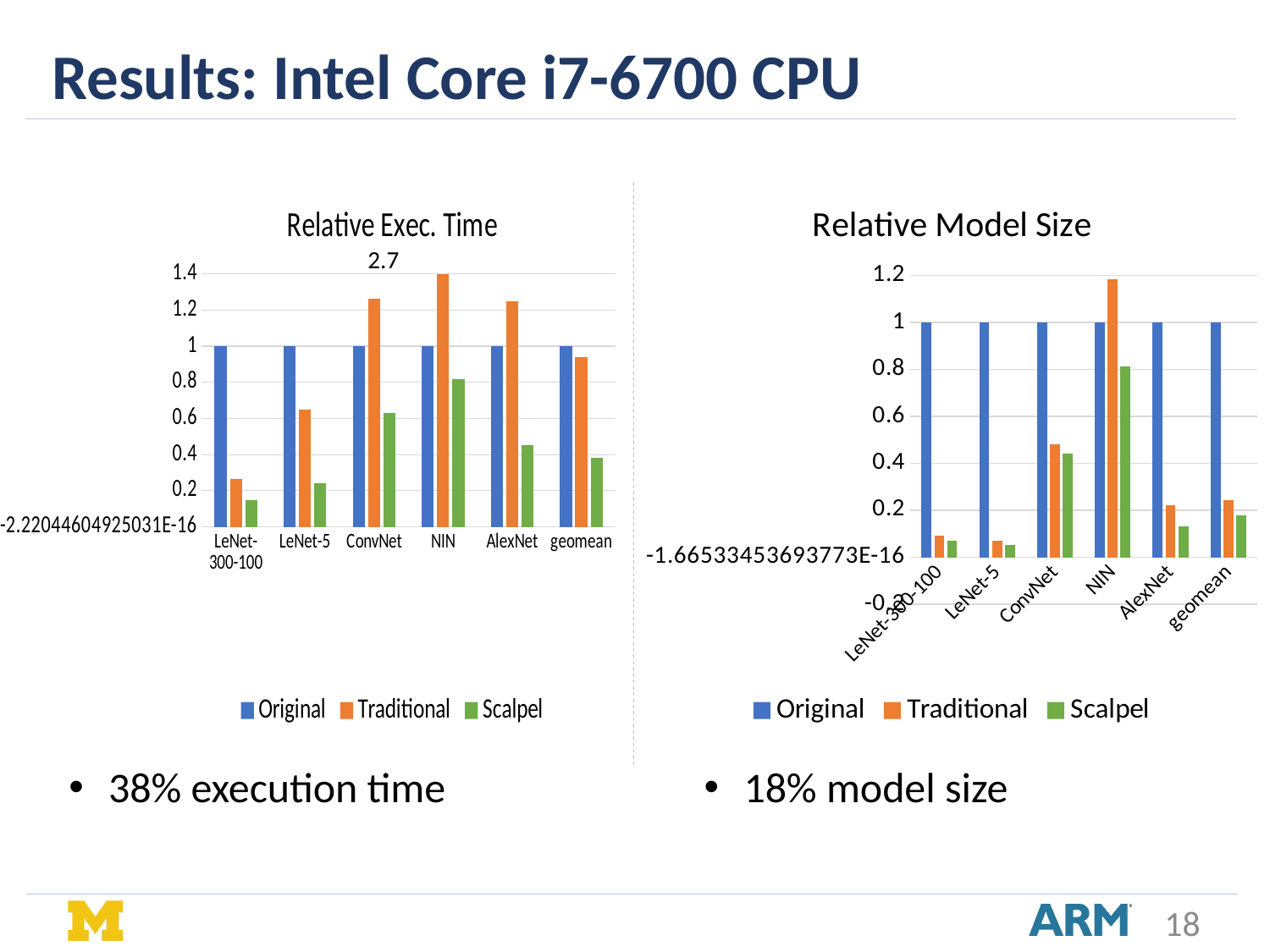
In the Relative Exec. Time chart, what is the Original value for ConvNet? 1 In the Relative Model Size chart, which is larger for NIN: the Traditional value or the Original value? Traditional What kind of chart is the Relative Exec. Time chart? bar chart In the Relative Exec. Time chart, what is the Traditional value for NIN? 2.7 In the Relative Exec. Time chart, is the Scalpel value for LeNet-300-100 greater or less than 0.2? less In the Relative Exec. Time chart, is the Traditional value for ConvNet greater or less than 1? greater How many series does the legend of the Relative Model Size chart list? 3 How many categories are shown on the x axis of the Relative Exec. Time chart? 6 In the Relative Model Size chart, is the Scalpel value for NIN greater or less than 0.6? greater In the Relative Model Size chart, what is the Original value for AlexNet? 1 In the Relative Model Size chart, which category has the highest Traditional value? NIN In the Relative Exec. Time chart, which category has the lowest Scalpel value? LeNet-300-100